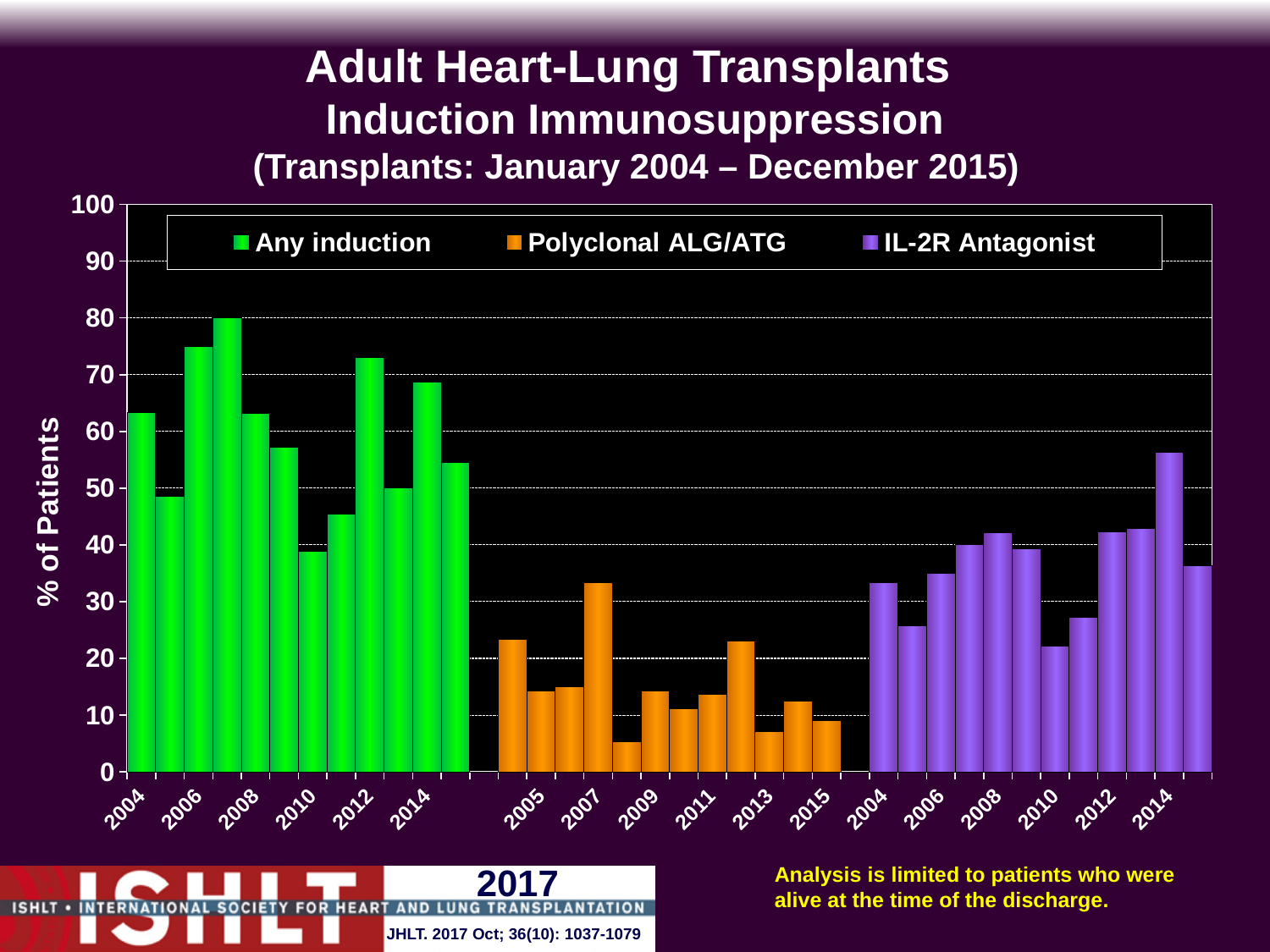
Is the value for Any induction in 2006 greater or less than 70? greater How many bars are plotted for the Any induction series? 12 Is the value for Polyclonal ALG/ATG in 2013 greater or less than 10? less Which year has the lowest value for IL-2R Antagonist? 2010 What is the label of the y axis? % of Patients What kind of chart is shown on the slide? bar chart Which year has the highest value for Polyclonal ALG/ATG? 2007 Is the value for IL-2R Antagonist in 2014 greater or less than 50? greater Which year has the highest value for IL-2R Antagonist? 2014 Which is larger for Any induction: the value in 2006 or the value in 2008? 2006 Which is larger for Polyclonal ALG/ATG: the value in 2005 or the value in 2007? 2007 How many series does the legend list? 3